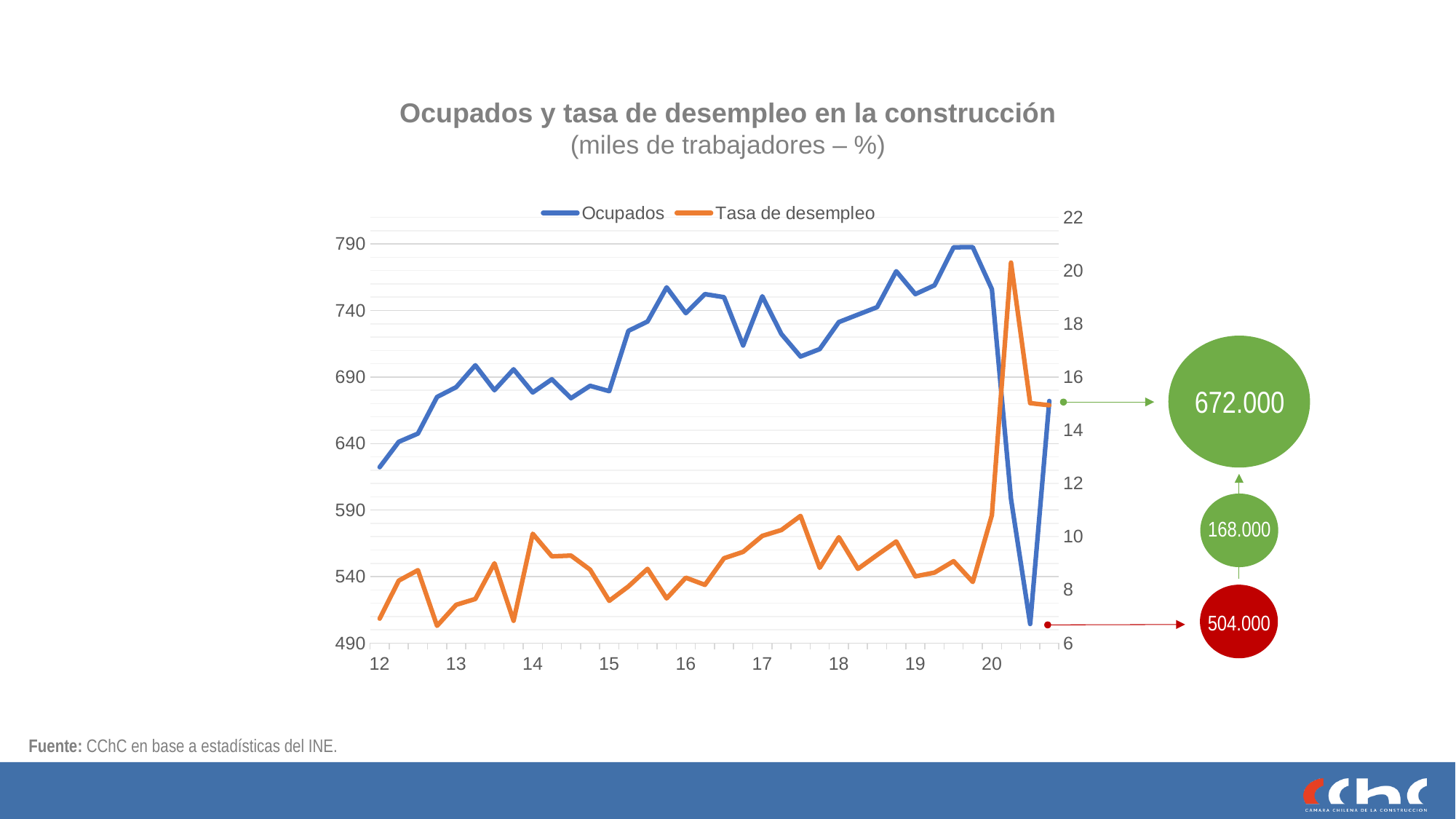
What value is shown in the red circle pointing to the lowest Ocupados point? 504.000 How many series does the legend list? 2 What are the two series named in the legend? Ocupados and Tasa de desempleo Is the highest Ocupados value, reached around year 19, greater or less than 740? greater Is the Ocupados value at the start of the series (year 12) greater or less than 640? less What is the title of the chart? Ocupados y tasa de desempleo en la construcción Is the peak value of the Tasa de desempleo series greater or less than 18? greater Does the Ocupados series generally rise or fall between year 12 and year 19? rise Around which year on the x axis does the Tasa de desempleo series reach its highest value? 20 What is the difference between the value in the green circle (672.000) and the value in the red circle (504.000)? 168.000 What value is shown in the large green circle pointing to the last Ocupados point? 672.000 What kind of chart is shown on the slide? line chart